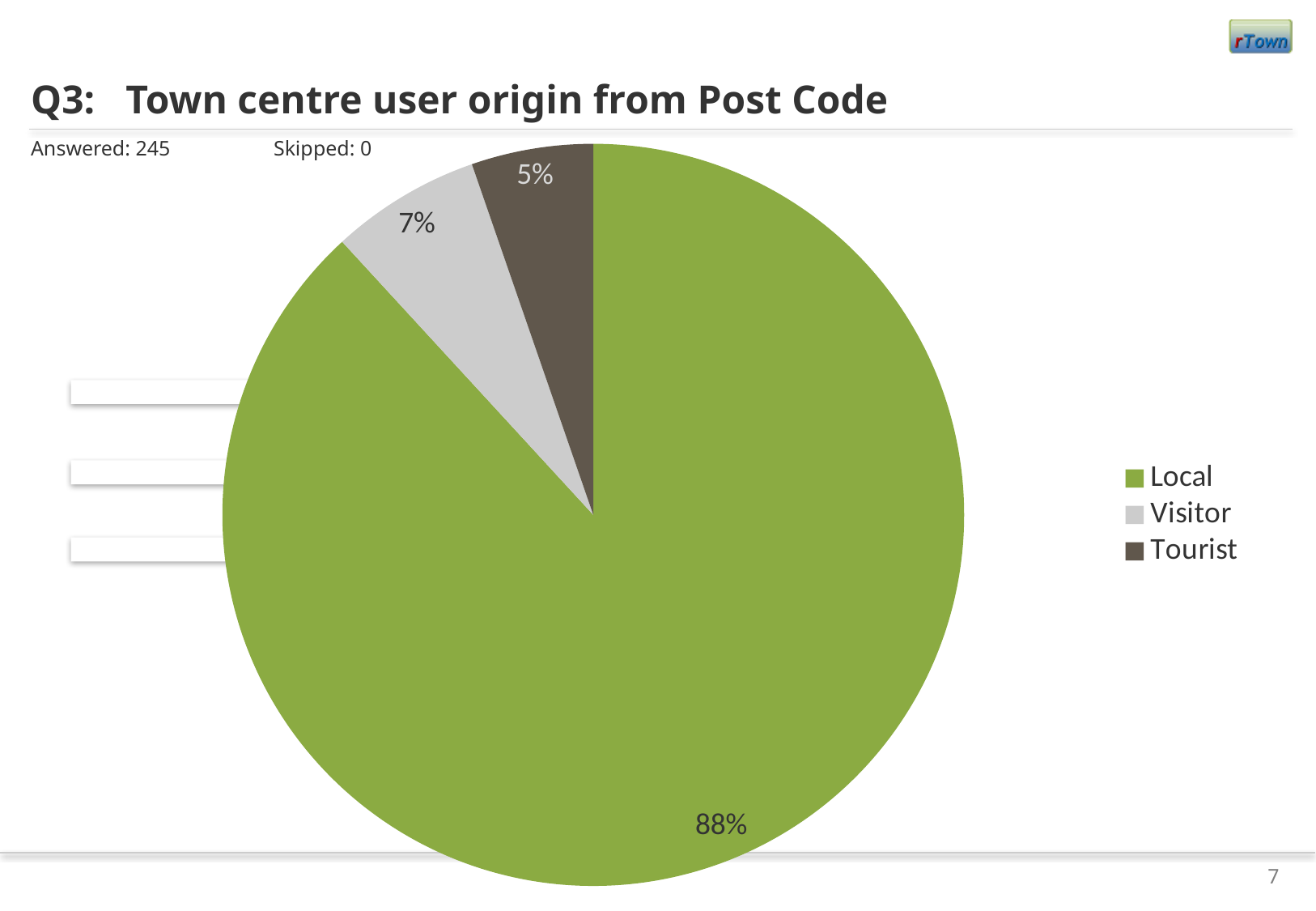
How many respondents answered this question? 245 How many entries does the legend list? 3 Which category has the smallest share of the pie? Tourist What share of town centre users are Local? 88% What is the difference in percentage points between the Local and Visitor shares? 81 Which category has the largest share of the pie? Local What is the title of the chart? Q3: Town centre user origin from Post Code What share of town centre users are Visitors? 7% How many categories does the pie chart show? 3 What share of town centre users are Tourists? 5% Which is larger, the Visitor share or the Tourist share? Visitor What kind of chart is shown on the slide? pie chart